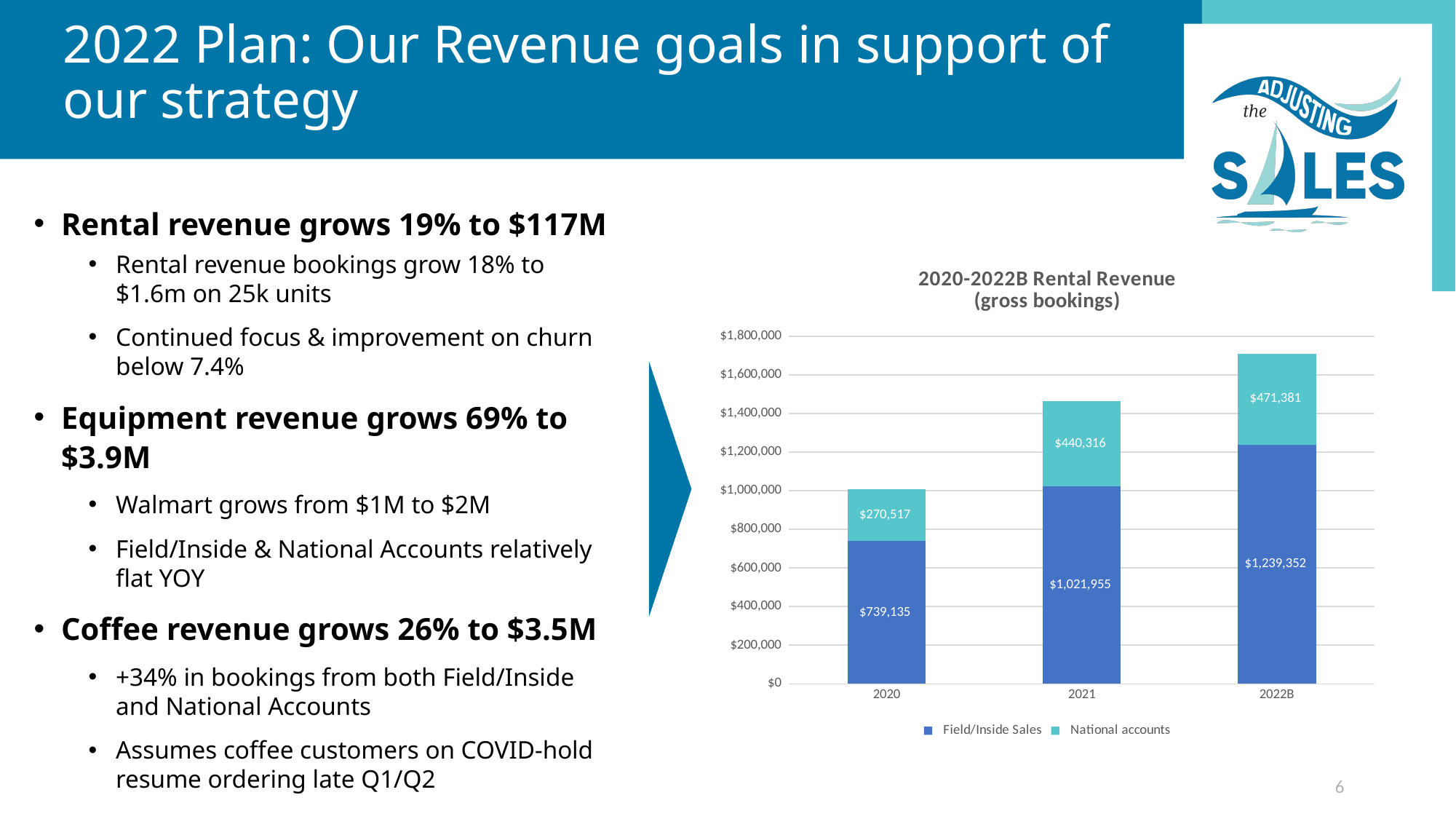
What is the difference between the Field/Inside Sales values for 2022B and 2021? $217,397 How many series does the legend list? 2 How many years are shown on the x axis? 3 Which year has the highest Field/Inside Sales value? 2022B Which is larger: the National accounts value for 2021 or for 2020? 2021 What is the Field/Inside Sales value for 2021? $1,021,955 Is the total stacked bar for 2022B greater or less than $1,600,000? greater What is the National accounts value for 2020? $270,517 What kind of chart is shown? Stacked bar chart What is the National accounts value for 2022B? $471,381 What is the total of the stacked bar for 2020? $1,009,652 Which year has the lowest National accounts value? 2020